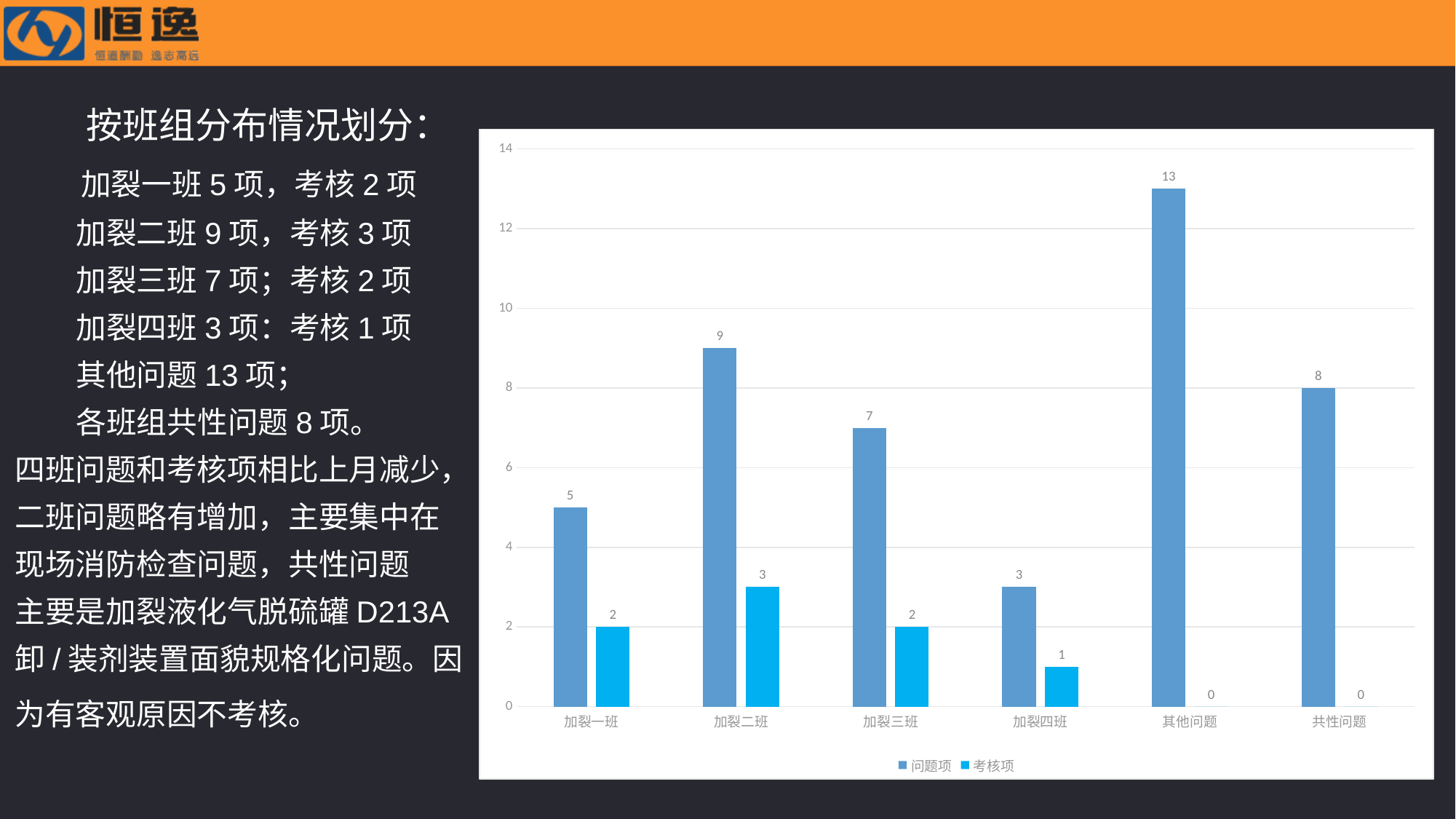
Which category has the lowest 问题项 value? 加裂四班 What is the value of 考核项 for 加裂二班? 3 How many categories are shown on the x axis? 6 Which is larger, the 问题项 value for 共性问题 or for 加裂三班? 共性问题 What kind of chart is shown on the slide? bar chart What is the value of 问题项 for 其他问题? 13 What is the value of 问题项 for 加裂三班? 7 How many series does the legend list? 2 Which category has the highest 问题项 value? 其他问题 What is the difference between the 问题项 values for 加裂二班 and 加裂一班? 4 What are the two series names listed in the legend? 问题项 and 考核项 What is the value of 考核项 for 共性问题? 0